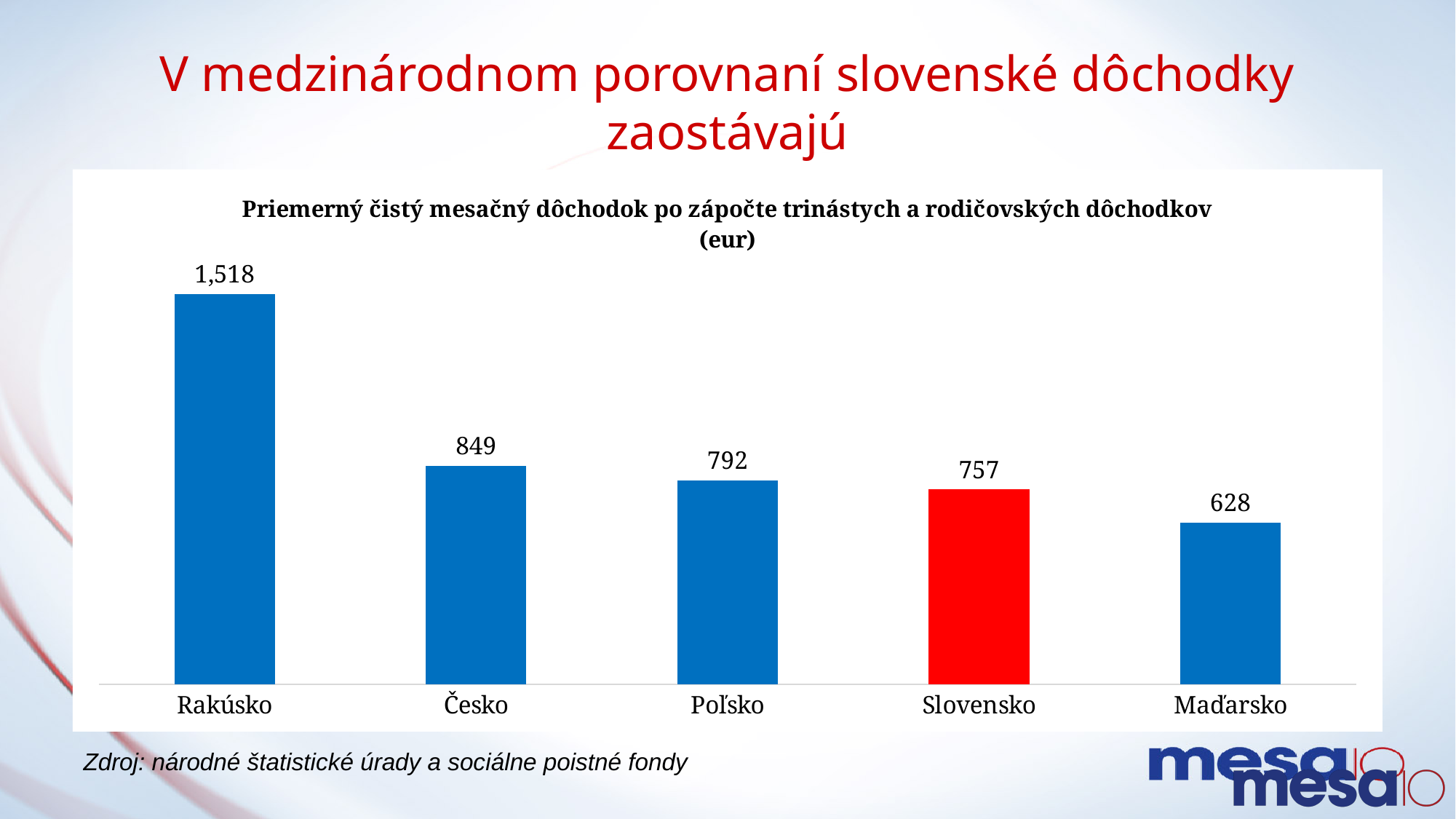
What is the value for Slovensko? 757 Which country has the highest value? Rakúsko Which country has the lowest value? Maďarsko Do the values rise or fall from left to right across the categories? fall Which bar is coloured red? Slovensko What is the value for Maďarsko? 628 What is the difference between the values for Česko and Poľsko? 57 What is the value for Rakúsko? 1,518 What kind of chart is this? bar chart Which is larger, the value for Poľsko or the value for Slovensko? Poľsko What is the difference between the values for Rakúsko and Slovensko? 761 How many countries are shown in the chart? 5